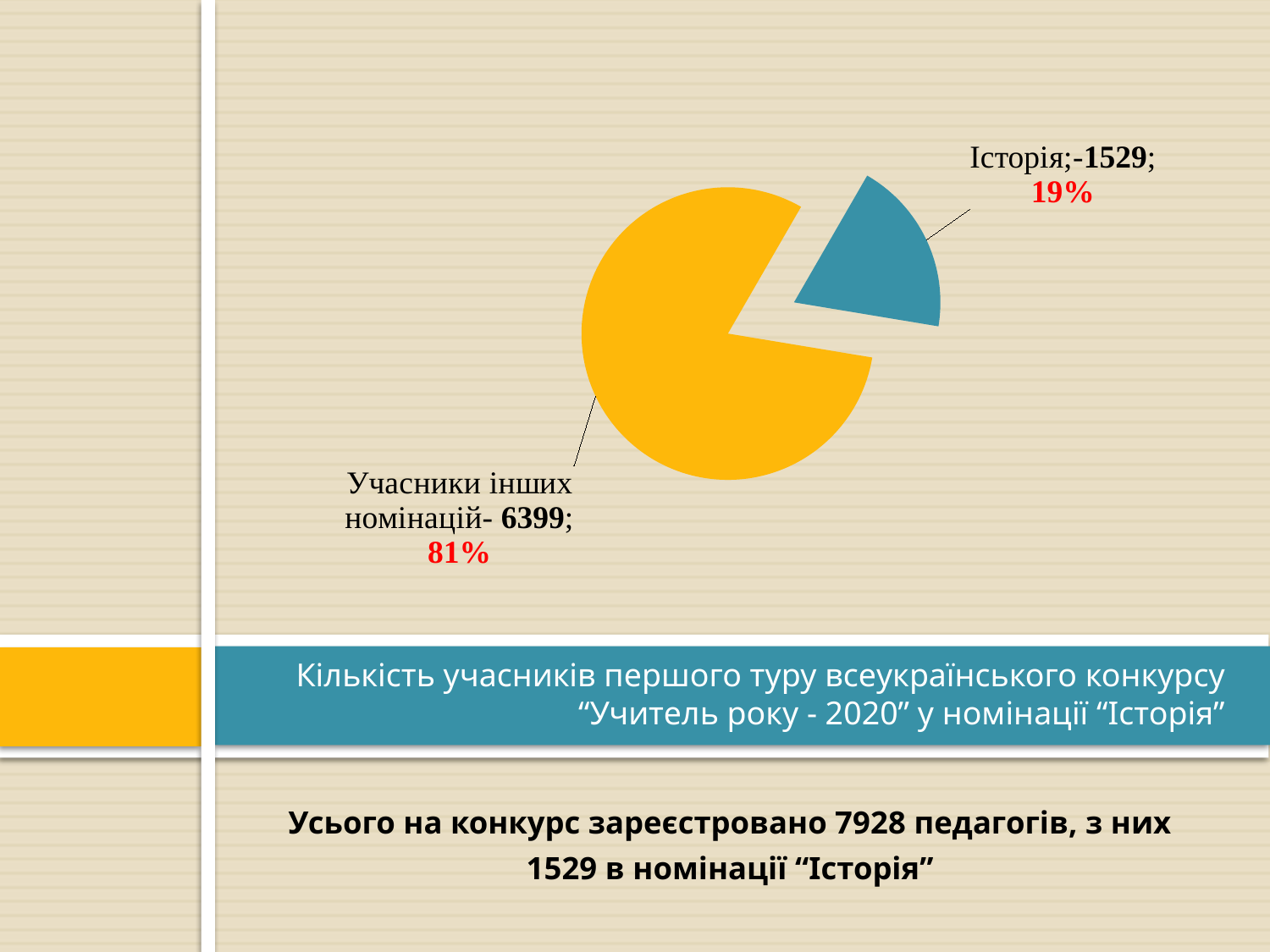
What is the difference between the values for "Учасники інших номінацій" and "Історія"? 4870 How many slices does the pie chart have? 2 Which slice of the pie chart is the largest? Учасники інших номінацій Which slice of the pie chart is the smallest? Історія What share of the pie does the "Історія" slice represent? 19% What is the total of the two slice values in the pie chart? 7928 Which is larger: the value for "Історія" or the value for "Учасники інших номінацій"? Учасники інших номінацій What kind of chart is shown on the slide? pie chart What share of the pie does the "Учасники інших номінацій" slice represent? 81% What colour is the "Історія" slice in the pie chart? teal (blue-green) What is the value shown for the "Учасники інших номінацій" slice? 6399 What is the value shown for the "Історія" slice? 1529